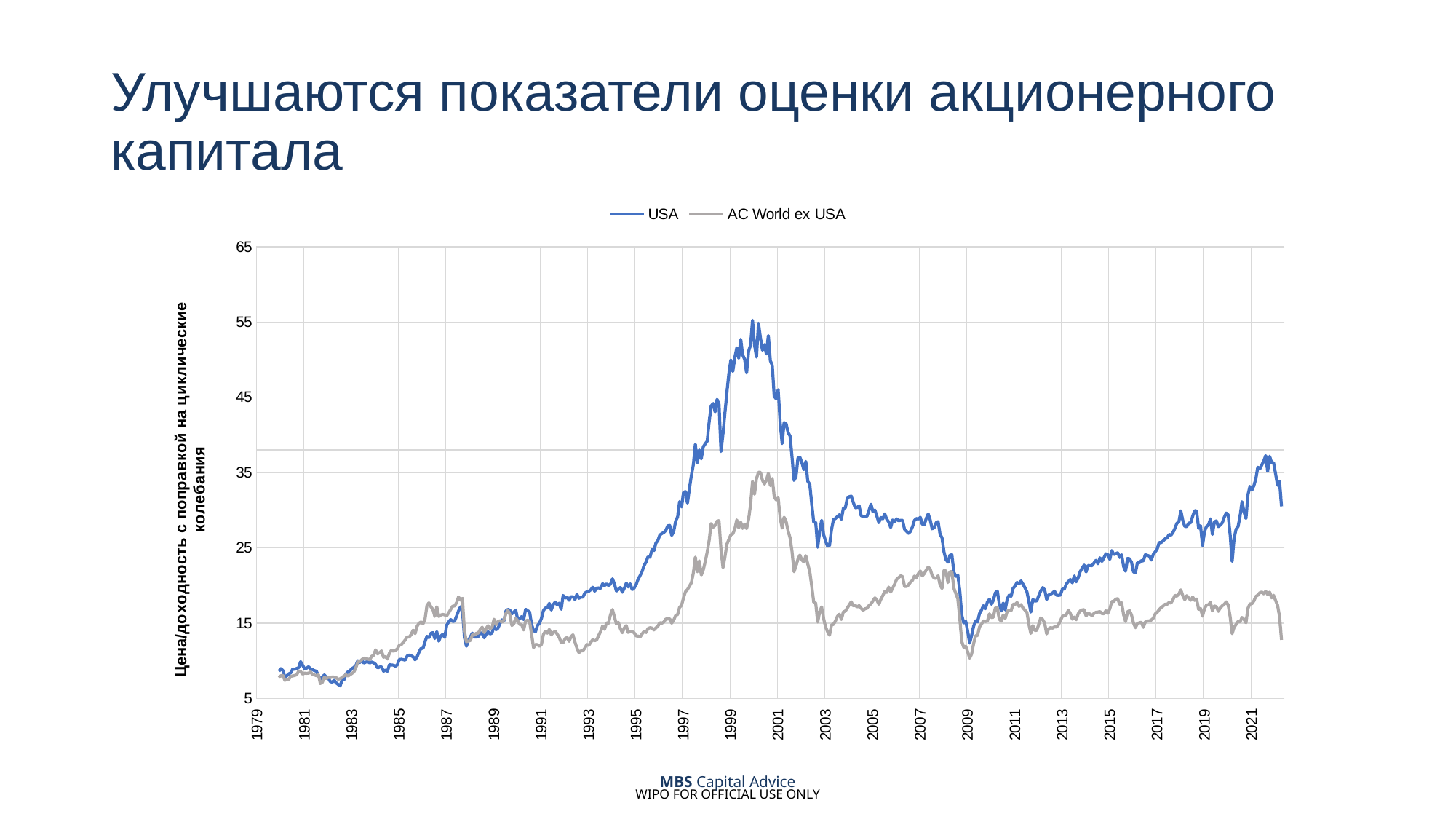
Is the peak value of the AC World ex USA series around 2000 greater or less than 45? less Which series reaches the higher peak around the year 2000, USA or AC World ex USA? USA Is the value of the USA series in 2009 greater or less than 25? less Does the USA series generally rise or fall between 2009 and 2021? rise How many series does the legend list? 2 What kind of chart is shown on the slide? line chart Is the value of the AC World ex USA series in 2021 greater or less than 25? less Which series is higher in 2019, USA or AC World ex USA? USA Does the USA series rise or fall between 1995 and 2000? rise What are the two series named in the legend? USA and AC World ex USA What is the label on the vertical axis? Цена/доходность с поправкой на циклические колебания